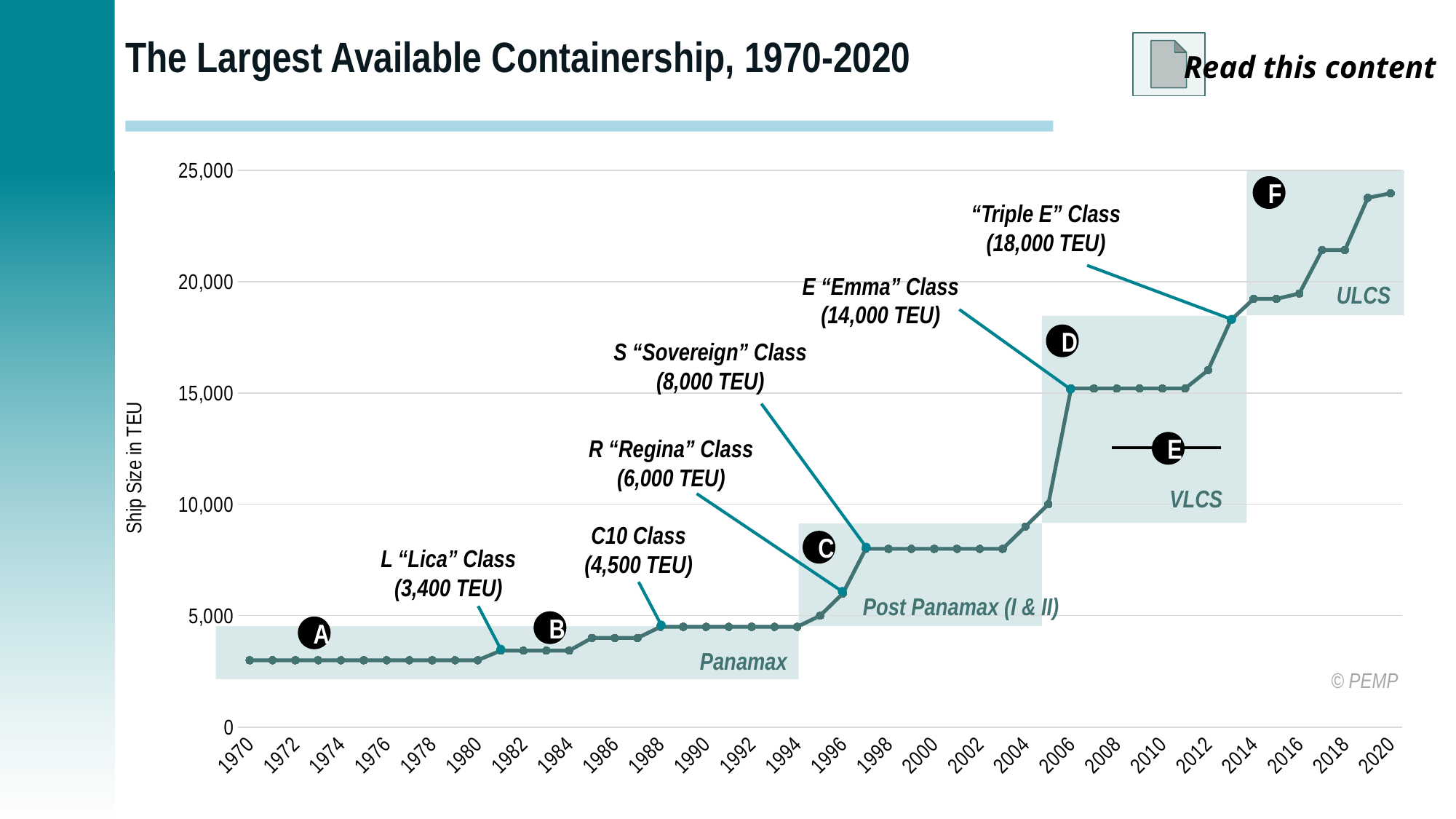
Which has the larger ship size given, the R "Regina" Class or the S "Sovereign" Class? S "Sovereign" Class What ship size is given for the L "Lica" Class? 3,400 TEU Overall, does the ship size rise or fall from 1970 to 2020? rise What is the title of the chart? The Largest Available Containership, 1970-2020 What ship size is given for the E "Emma" Class? 14,000 TEU What is the label on the vertical axis? Ship Size in TEU Is the ship size plotted for 2020 greater or less than 20,000? greater What ship size is given for the "Triple E" Class? 18,000 TEU What kind of chart is shown on the slide? line chart Is the ship size plotted for 1970 greater or less than 5,000? less What ship size is given for the C10 Class? 4,500 TEU What is the difference between the ship sizes given for the "Triple E" Class and the E "Emma" Class? 4,000 TEU